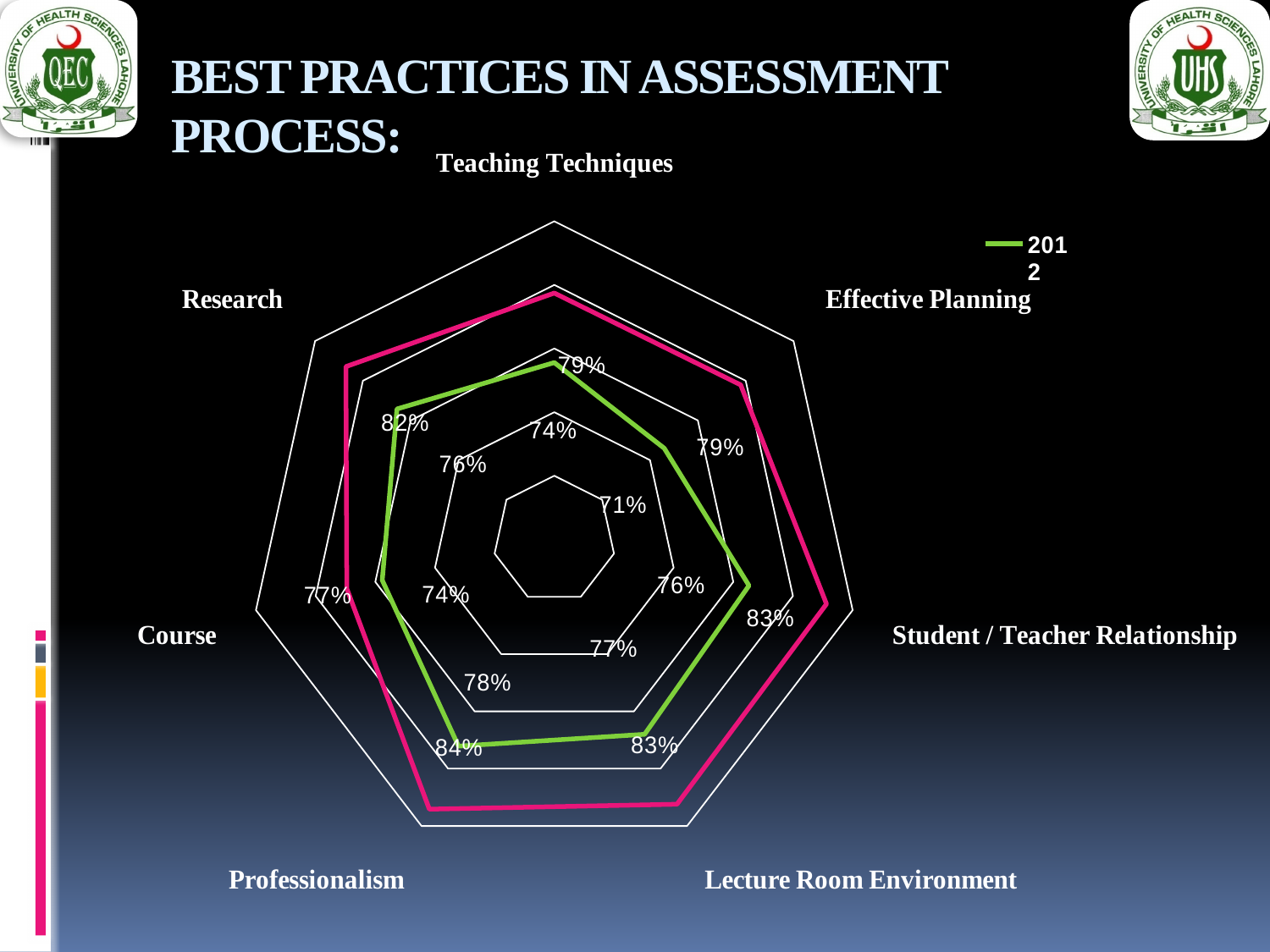
How many categories (axes) does the radar chart have? 7 What is the 2012 value for Student / Teacher Relationship? 76% What colour is the line for the 2012 series? Green What is the 2012 value for Professionalism? 78% How many series does the legend list? 1 What kind of chart is shown on the slide? Radar chart What is the difference between the 2012 values for Professionalism and Course? 4 percentage points Which category has the highest 2012 value? Professionalism Which category has the lowest 2012 value? Effective Planning What is the 2012 value for Course? 74% What is the 2012 value for Teaching Techniques? 74% What is the 2012 value for Research? 76%